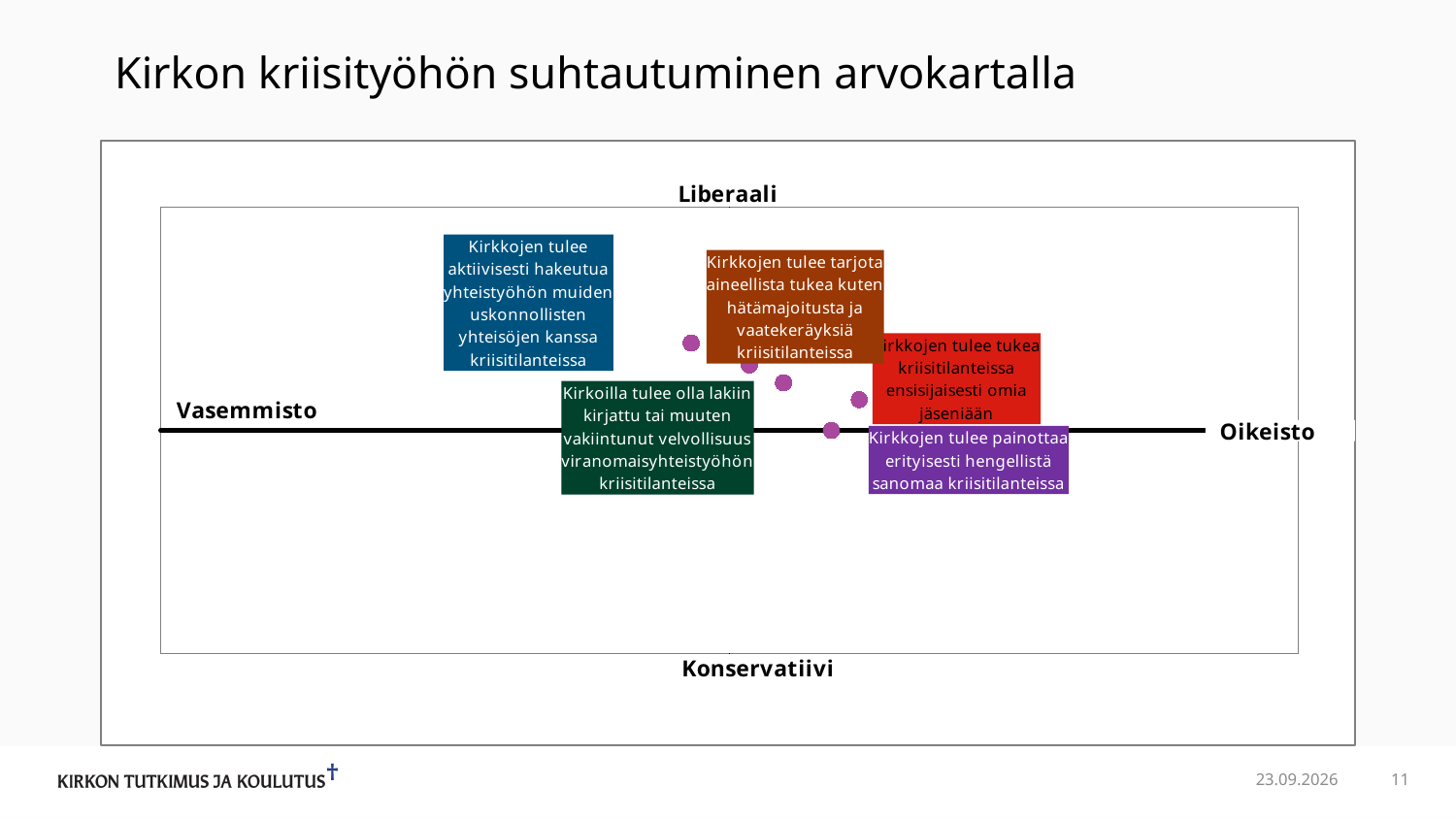
What kind of chart is shown on the slide? Scatter chart Is the point for 'Kirkkojen tulee painottaa erityisesti hengellistä sanomaa kriisitilanteissa' placed to the left or right of the vertical axis? Right How many data points are plotted on the value map? 5 How many of the plotted points lie to the right of the vertical axis (on the Oikeisto side)? 4 What label is at the bottom of the vertical axis? Konservatiivi What label is at the right end of the horizontal axis? Oikeisto What is the title of the slide? Kirkon kriisityöhön suhtautuminen arvokartalla